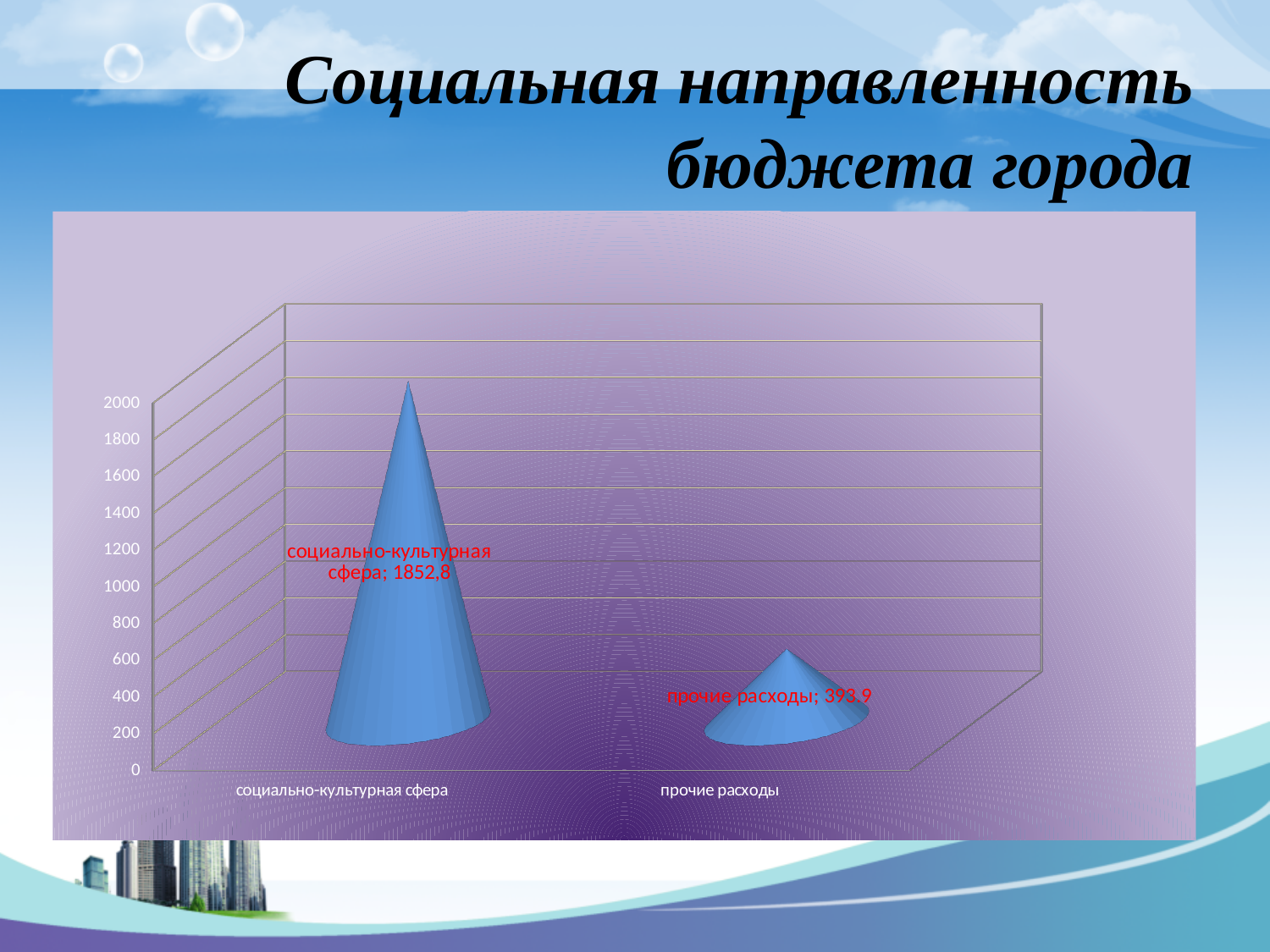
What is the value for социально-культурная сфера? 1852,8 How many categories are shown on the chart? 2 Which is larger, the value for социально-культурная сфера or the value for прочие расходы? социально-культурная сфера Is the value for социально-культурная сфера greater or less than 1600? greater Is the value for прочие расходы greater or less than 600? less What is the value for прочие расходы? 393.9 Which category has the lowest value? прочие расходы What is the title of the slide? Социальная направленность бюджета города What kind of chart is shown on the slide? bar chart Which category has the highest value? социально-культурная сфера Do the values rise or fall from the first category to the second along the x axis? fall What is the difference between the values for социально-культурная сфера and прочие расходы? 1458,9